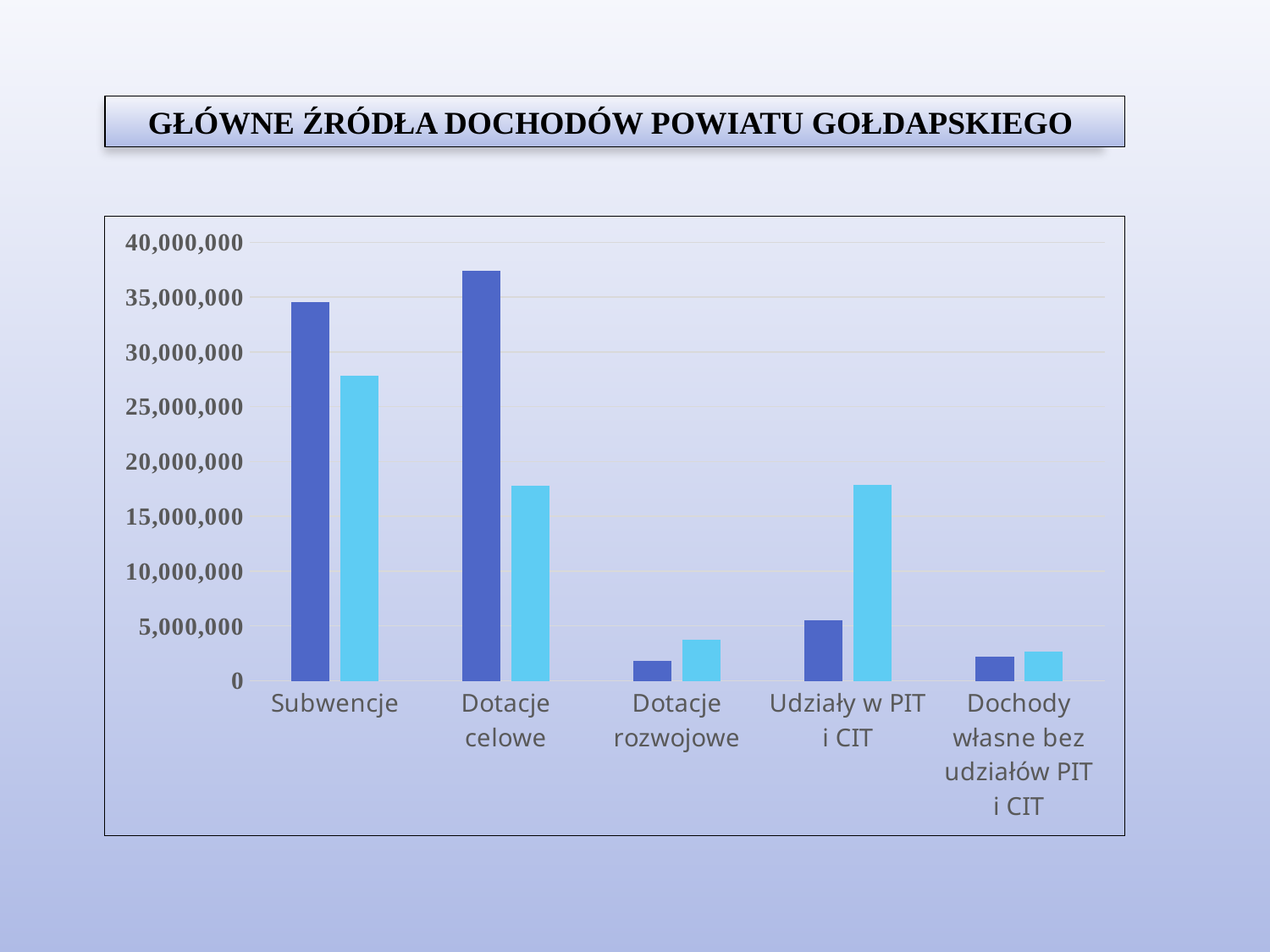
What kind of chart is shown on the slide? bar chart Which category has the shortest dark blue bar? Dotacje rozwojowe How many categories are shown on the x axis of the chart? 5 For Udziały w PIT i CIT, which bar is taller, the dark blue or the light blue? light blue Is the dark blue bar for Subwencje greater or less than 30,000,000? greater Is the dark blue bar for Udziały w PIT i CIT greater or less than 10,000,000? less Is the light blue bar for Dotacje celowe greater or less than 20,000,000? less For Dotacje celowe, which bar is taller, the dark blue or the light blue? dark blue Which category has the shortest light blue bar? Dochody własne bez udziałów PIT i CIT Which category has the tallest light blue bar? Subwencje Which category has the tallest dark blue bar? Dotacje celowe What is the title shown above the chart? GŁÓWNE ŹRÓDŁA DOCHODÓW POWIATU GOŁDAPSKIEGO